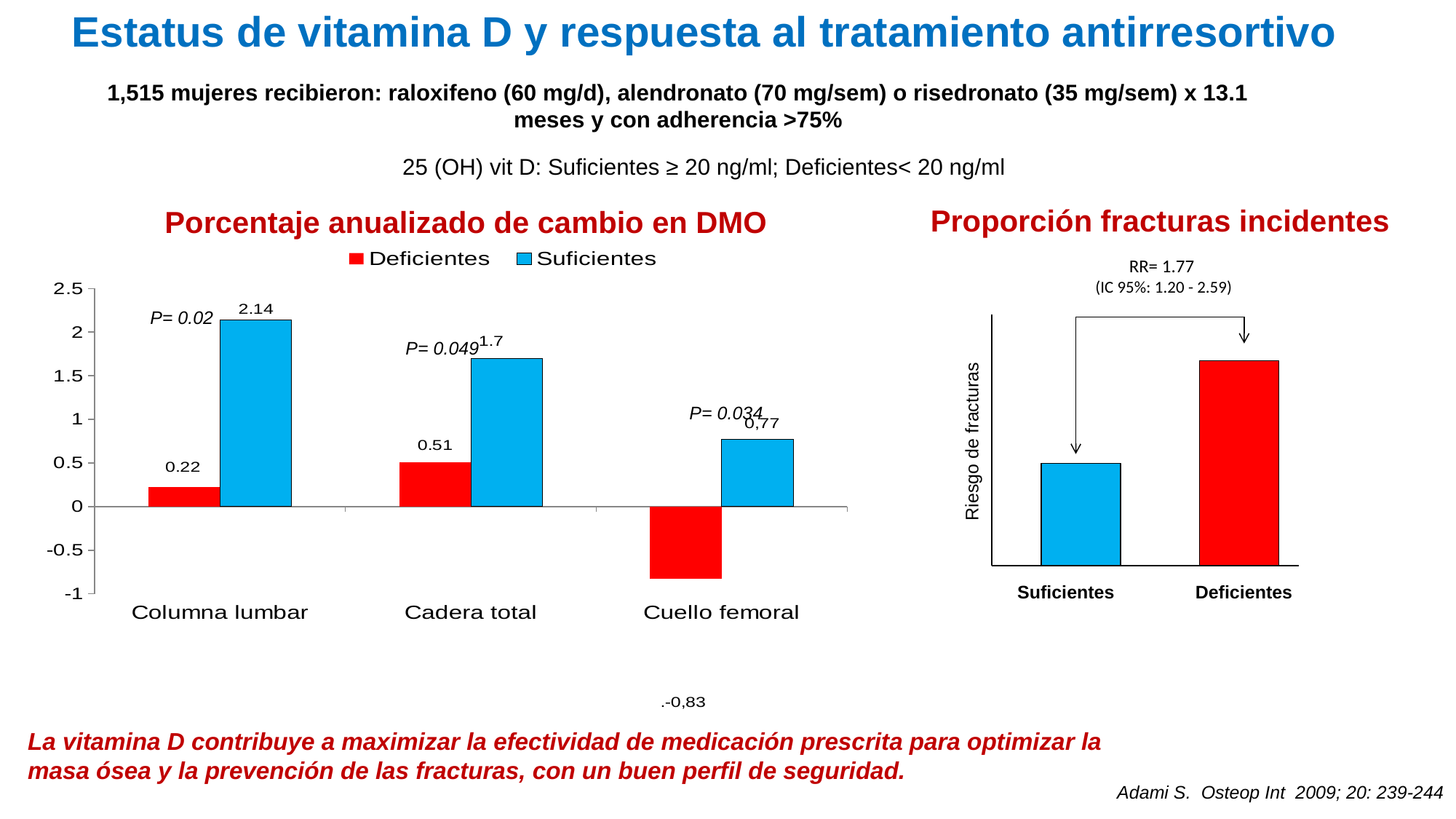
In the 'Proporción fracturas incidentes' chart, which bar is taller: Suficientes or Deficientes? Deficientes In the 'Porcentaje anualizado de cambio en DMO' chart, what is the value for Deficientes at Columna lumbar? 0.22 In the 'Porcentaje anualizado de cambio en DMO' chart, what is the value for Deficientes at Cadera total? 0.51 In the 'Porcentaje anualizado de cambio en DMO' chart, which category has the lowest Deficientes value? Cuello femoral In the 'Porcentaje anualizado de cambio en DMO' chart, how many categories are shown on the x axis? 3 In the 'Porcentaje anualizado de cambio en DMO' chart, what is the difference between the Suficientes and Deficientes values at Columna lumbar? 1.92 In the 'Porcentaje anualizado de cambio en DMO' chart, which is larger at Cadera total: Deficientes or Suficientes? Suficientes What kind of chart is the 'Proporción fracturas incidentes' chart? Bar chart In the 'Porcentaje anualizado de cambio en DMO' chart, which category has the highest Suficientes value? Columna lumbar In the 'Porcentaje anualizado de cambio en DMO' chart, what is the value for Suficientes at Columna lumbar? 2.14 In the 'Porcentaje anualizado de cambio en DMO' chart, what is the value for Suficientes at Cuello femoral? 0,77 In the 'Porcentaje anualizado de cambio en DMO' chart, how many series does the legend list? 2